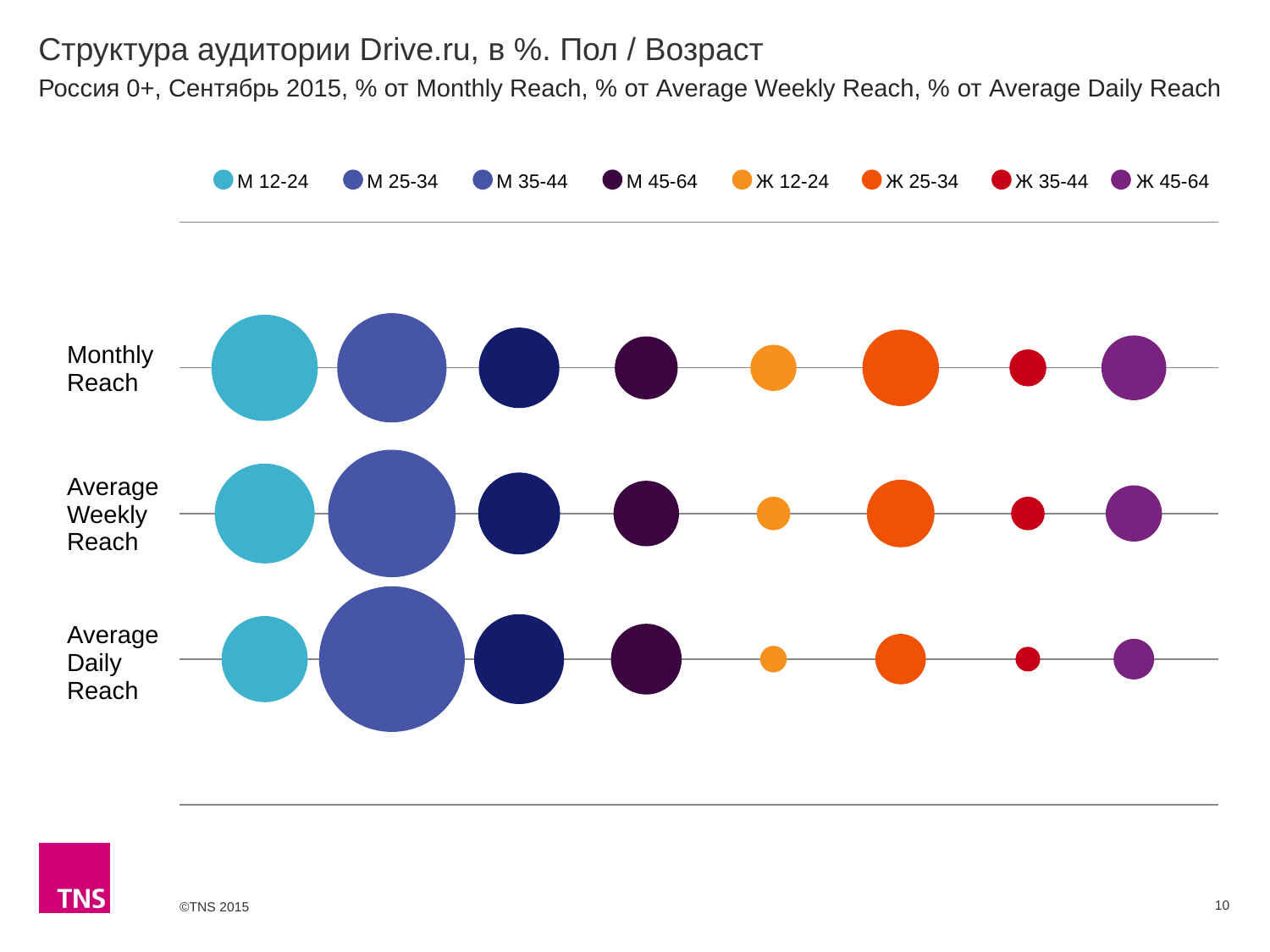
What kind of chart is shown on the slide? bubble chart Does the bubble for М 25-34 grow or shrink going from Monthly Reach to Average Daily Reach? grow What is the first entry in the chart legend? М 12-24 How many reach categories (rows) are plotted in the chart? 3 In the Monthly Reach row, which bubble is larger: Ж 25-34 or Ж 12-24? Ж 25-34 In the Average Weekly Reach row, which series has the largest bubble? М 25-34 Does the bubble for Ж 12-24 grow or shrink going from Monthly Reach to Average Daily Reach? shrink In the Average Daily Reach row, which series has the largest bubble? М 25-34 How many series does the legend list? 8 What colour is used for the Ж 25-34 series? orange In the Monthly Reach row, which bubble is larger: М 35-44 or М 45-64? М 35-44 In the Average Daily Reach row, which bubble is larger: М 12-24 or Ж 45-64? М 12-24